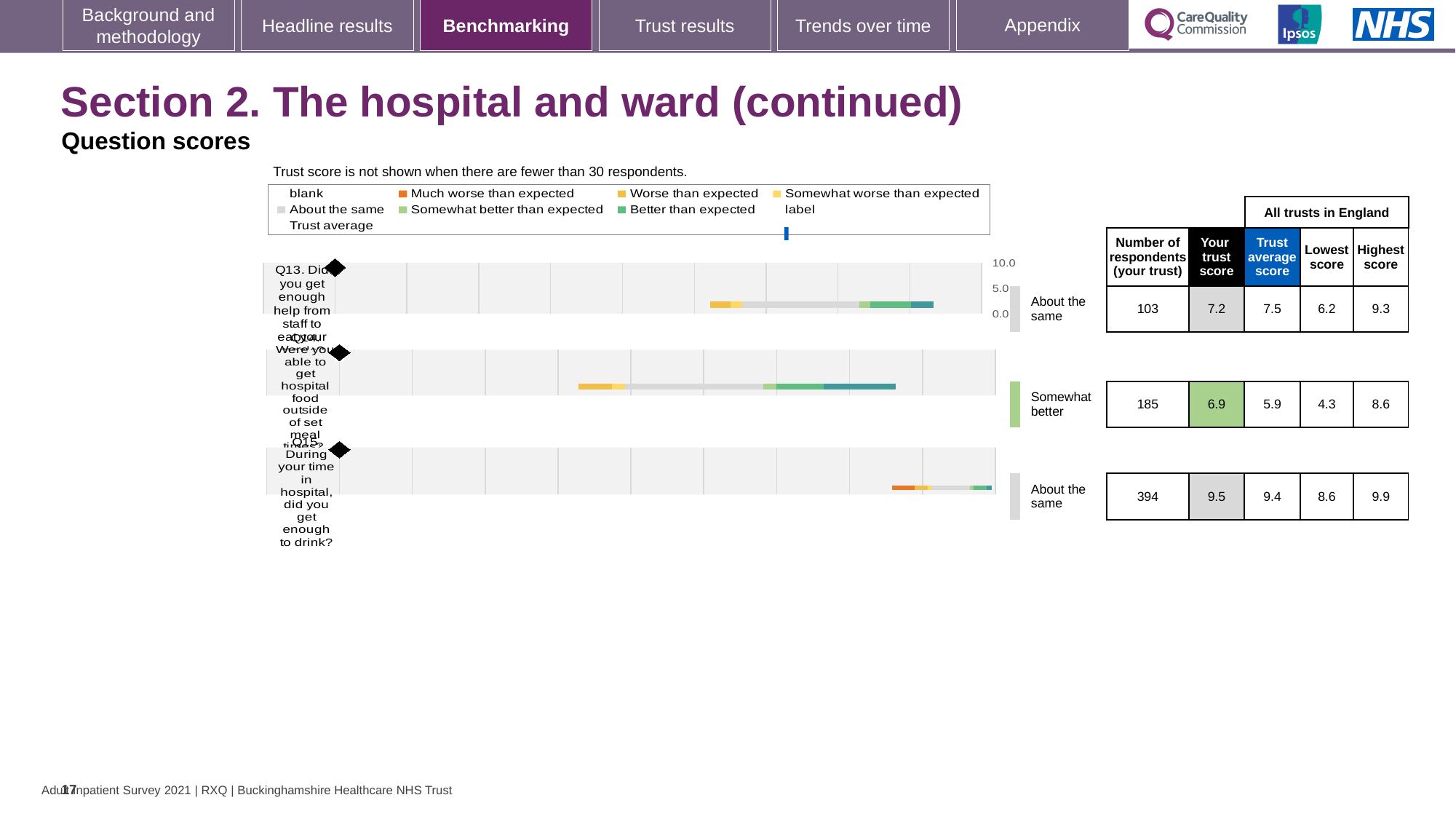
For Q13, which is larger: the trust score or the trust average score for all trusts in England? Trust average score What kind of chart is shown on the slide? Bar chart What is the trust average score across all trusts in England for Q14? 5.9 What is the trust score for Q13 (Did you get enough help from staff to eat your meals?)? 7.2 What is the difference between the trust score for Q15 and the trust score for Q14? 2.6 Which question has the highest trust score? Q15 What is the trust score for Q14 (Were you able to get hospital food outside of set meal times?)? 6.9 Which question has the lowest trust score? Q14 How many questions are plotted on the chart? 3 What is the trust score for Q15 (did you get enough to drink?)? 9.5 How many respondents answered Q15? 394 What is the highest score among all trusts in England for Q13? 9.3